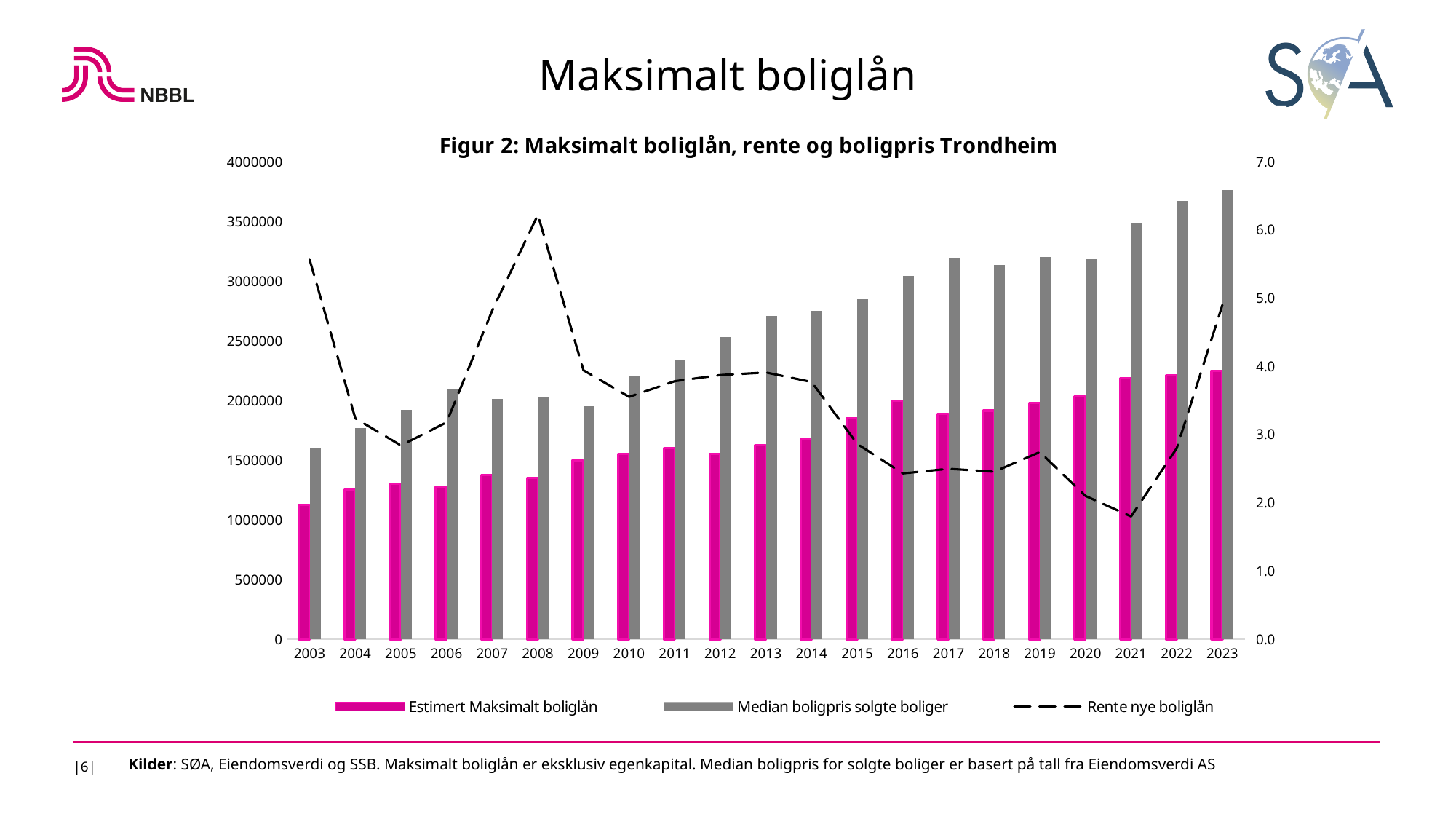
What kind of chart is shown on the slide? A combined bar and line chart In which year does Rente nye boliglån reach its highest value? 2008 Which is larger in 2010: Estimert Maksimalt boliglån or Median boligpris solgte boliger? Median boligpris solgte boliger Which year has the lowest value for Median boligpris solgte boliger? 2003 How many years are shown on the x axis? 21 What is the title of the chart? Figur 2: Maksimalt boliglån, rente og boligpris Trondheim Which year has the highest value for Median boligpris solgte boliger? 2023 How many series does the legend list? 3 Is the value for Rente nye boliglån in 2021 greater or less than 2.0? less In which year does Rente nye boliglån reach its lowest value? 2021 Is the value for Median boligpris solgte boliger in 2023 greater or less than 3500000? greater Which year has the lowest value for Estimert Maksimalt boliglån? 2003